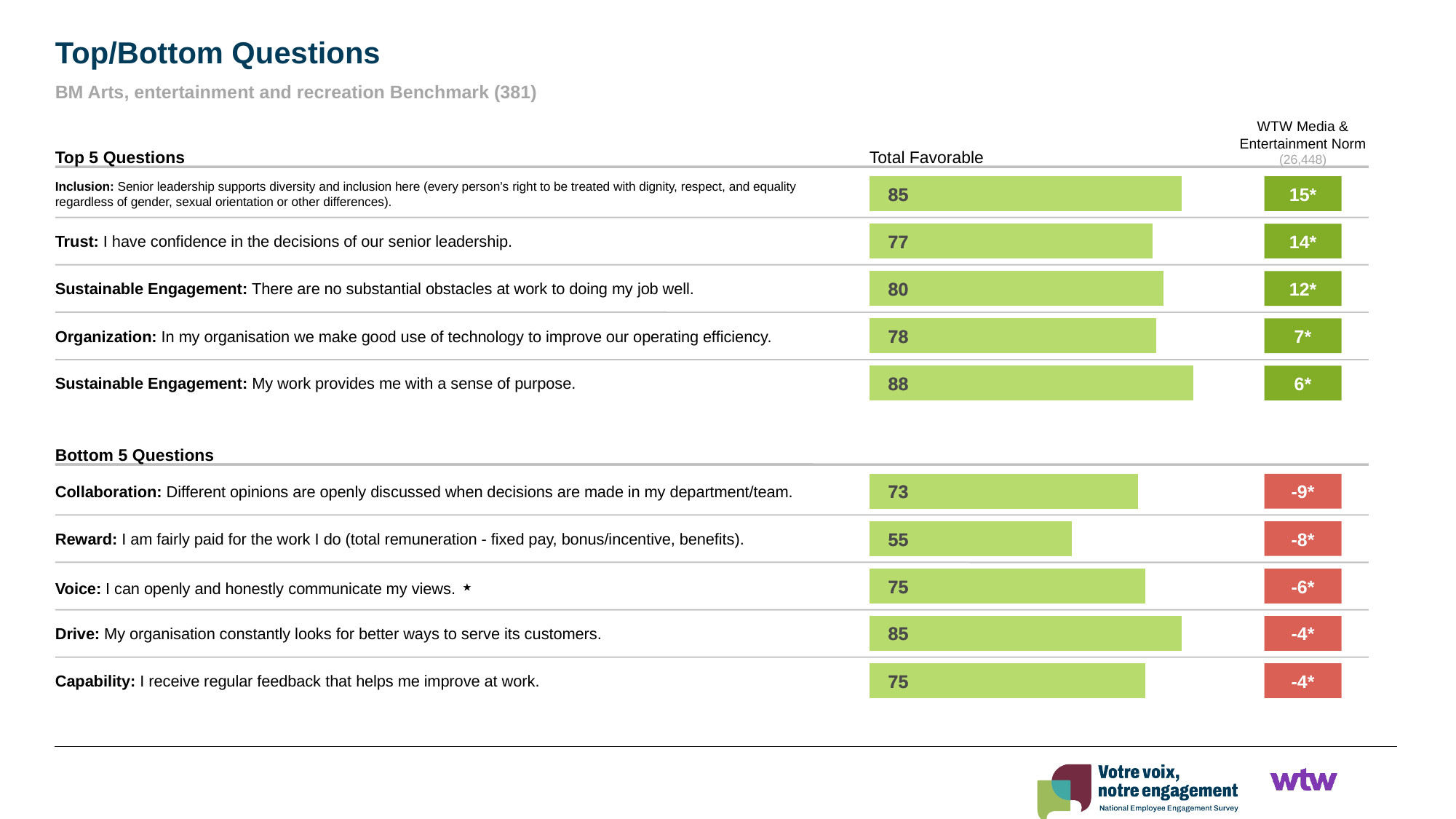
How many items are plotted in the Bottom 5 Questions chart? 5 In the Bottom 5 Questions chart, which item has the lowest Total Favorable value? Reward: I am fairly paid for the work I do (55) In the Top 5 Questions chart, what is the difference between the Total Favorable values for the Inclusion item (85) and the Trust item (77)? 8 In the Top 5 Questions chart, which item has the highest Total Favorable value? Sustainable Engagement: My work provides me with a sense of purpose (88) What is the sample size shown under the WTW Media & Entertainment Norm column header? 26,448 In the Bottom 5 Questions chart, what is the Total Favorable value for the Drive item? 85 What kind of chart is used to show the Total Favorable values on this slide? Bar chart In the Top 5 Questions chart, which has a higher Total Favorable value: the Organization item or the Sustainable Engagement item about no substantial obstacles at work? Sustainable Engagement: There are no substantial obstacles at work to doing my job well (80) In the Bottom 5 Questions chart, what is the WTW Media & Entertainment Norm difference shown for the Collaboration item? -9* In the Top 5 Questions chart, what is the WTW Media & Entertainment Norm difference shown for the Inclusion item? 15* In the Top 5 Questions chart, what is the Total Favorable value for the Trust item (I have confidence in the decisions of our senior leadership)? 77 In the Bottom 5 Questions chart, what is the difference between the Total Favorable values for the Collaboration item (73) and the Reward item (55)? 18